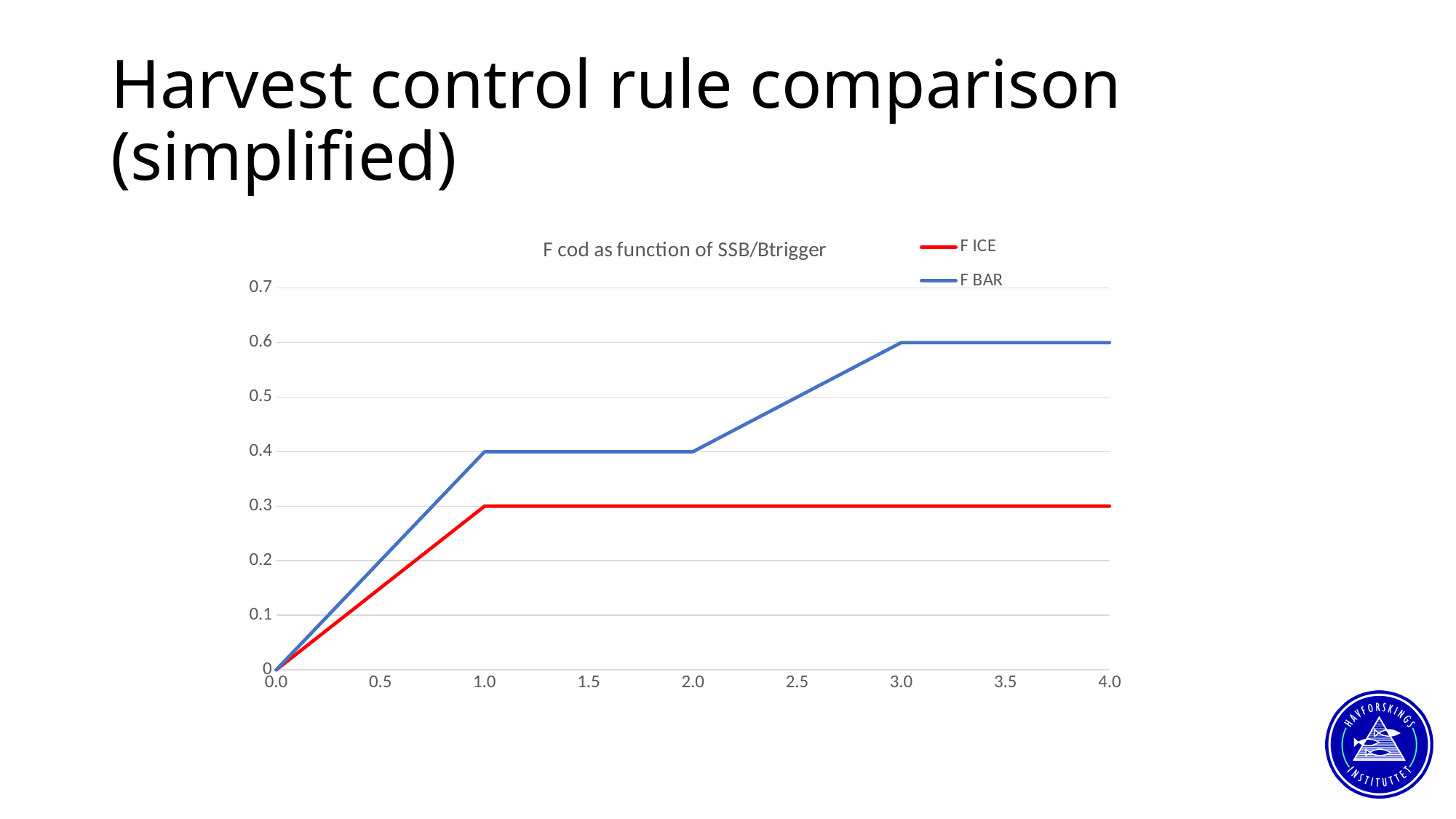
What is the value of F BAR at SSB/Btrigger = 0.0? 0 What is the value of F BAR at SSB/Btrigger = 1.5? 0.4 What is the title of the chart? F cod as function of SSB/Btrigger What is the difference between F BAR and F ICE at SSB/Btrigger = 4.0? 0.3 Which series has the higher value at SSB/Btrigger = 3.0, F ICE or F BAR? F BAR What is the value of F BAR at SSB/Btrigger = 4.0? 0.6 What is the value of F ICE at SSB/Btrigger = 4.0? 0.3 Which series is drawn in red? F ICE Is the value of F BAR at SSB/Btrigger = 2.5 greater or less than 0.4? greater How many series does the legend list? 2 Does F ICE rise or stay flat between SSB/Btrigger = 1.0 and 4.0? stays flat What kind of chart is shown on the slide? line chart